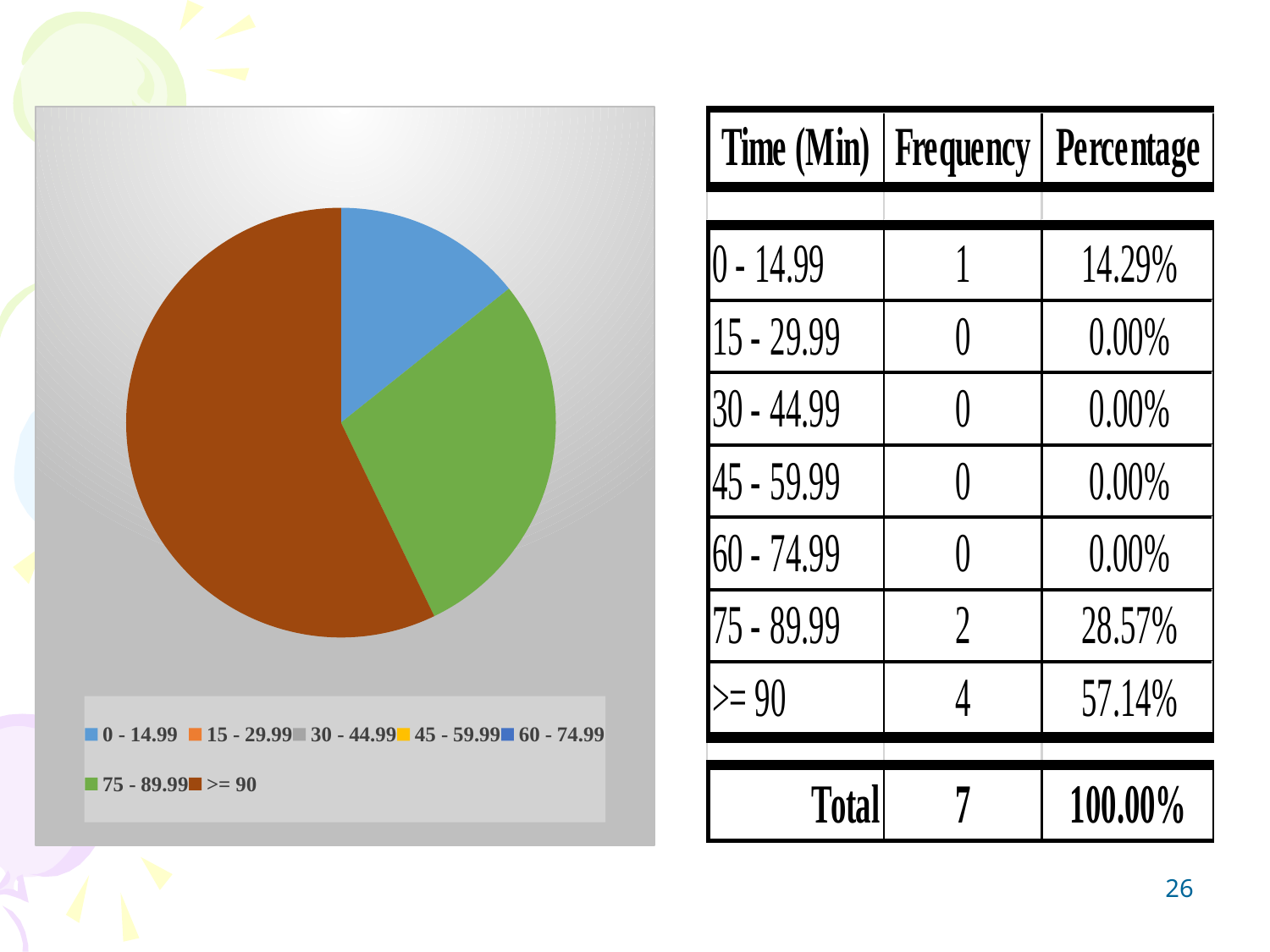
What is the total frequency shown in the table on the slide? 7 According to the table on the slide, what is the frequency for the 0 - 14.99 category? 1 According to the table on the slide, what percentage of the pie does the >= 90 slice represent? 57.14% How many slices are visible in the pie chart? 3 Is the share of the >= 90 slice greater or less than 50% of the pie? greater What kind of chart is shown on the left of the slide? pie chart Which of the visible slices in the pie chart is the smallest? 0 - 14.99 What colour is the >= 90 slice in the pie chart? brown How many categories does the pie chart's legend list? 7 According to the table on the slide, what percentage of the pie does the 75 - 89.99 slice represent? 28.57% Which slice is larger in the pie chart, 75 - 89.99 or 0 - 14.99? 75 - 89.99 Which category has the largest slice in the pie chart? >= 90